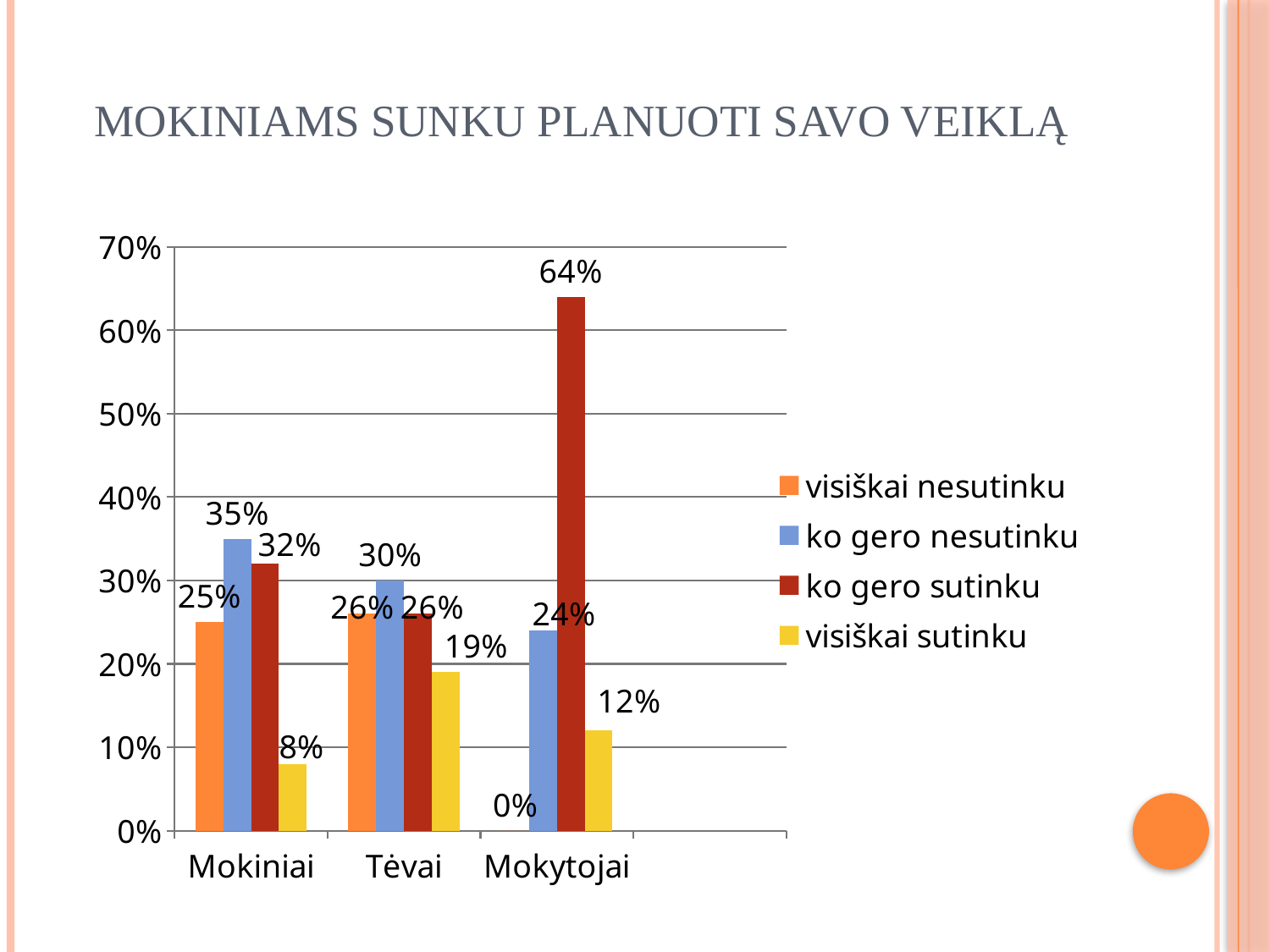
What kind of chart is shown on the slide? Bar chart What is the value for "visiškai nesutinku" in the Mokiniai category? 25% What is the value for "ko gero sutinku" in the Mokytojai category? 64% How many categories are shown on the x axis? 3 Which is larger: the "ko gero nesutinku" value for Mokiniai or for Tėvai? Mokiniai What is the value for "visiškai sutinku" in the Tėvai category? 19% Which category has the highest value for "ko gero sutinku"? Mokytojai Which category has the lowest value for "visiškai sutinku"? Mokiniai What is the difference between the "ko gero sutinku" value for Mokytojai and for Mokiniai? 32% What is the value for "visiškai nesutinku" in the Mokytojai category? 0% What is the title of the slide? MOKINIAMS SUNKU PLANUOTI SAVO VEIKLĄ How many series does the legend list? 4